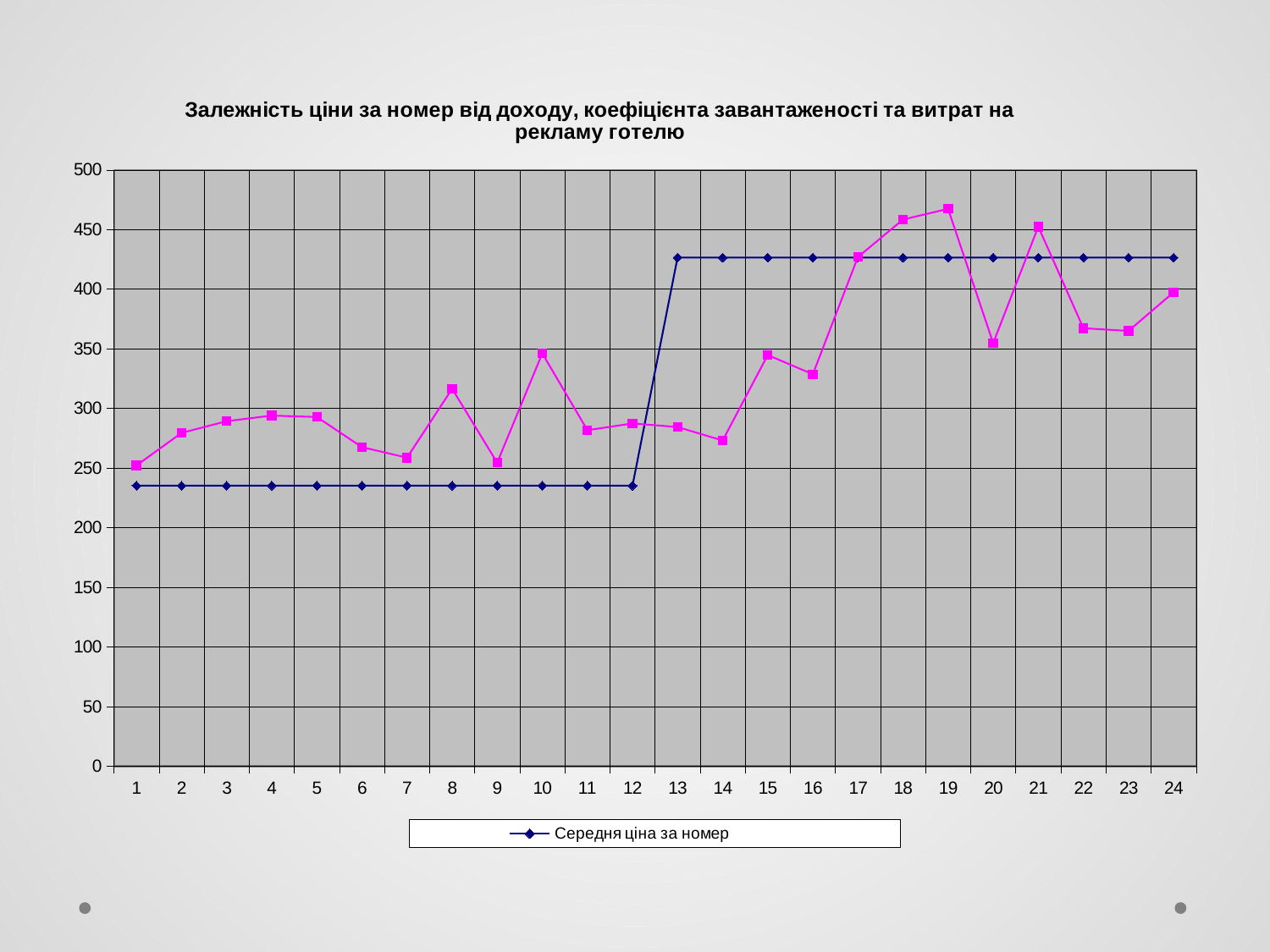
Is the value of the magenta line with square markers at point 9 greater or less than 300? less At point 10, which line is higher: the blue Середня ціна за номер line or the magenta line with square markers? the magenta line What is the name of the series listed in the legend? Середня ціна за номер Is the value of the magenta line with square markers at point 19 greater or less than 450? greater What kind of chart is shown on the slide? line chart Does the Середня ціна за номер series rise or fall between point 12 and point 13? rise How many points are plotted along the x axis for each series? 24 At point 20, which line is higher: the blue Середня ціна за номер line or the magenta line with square markers? the blue Середня ціна за номер line Is the value of the magenta line with square markers at point 1 greater or less than 300? less How many series does the legend list? 1